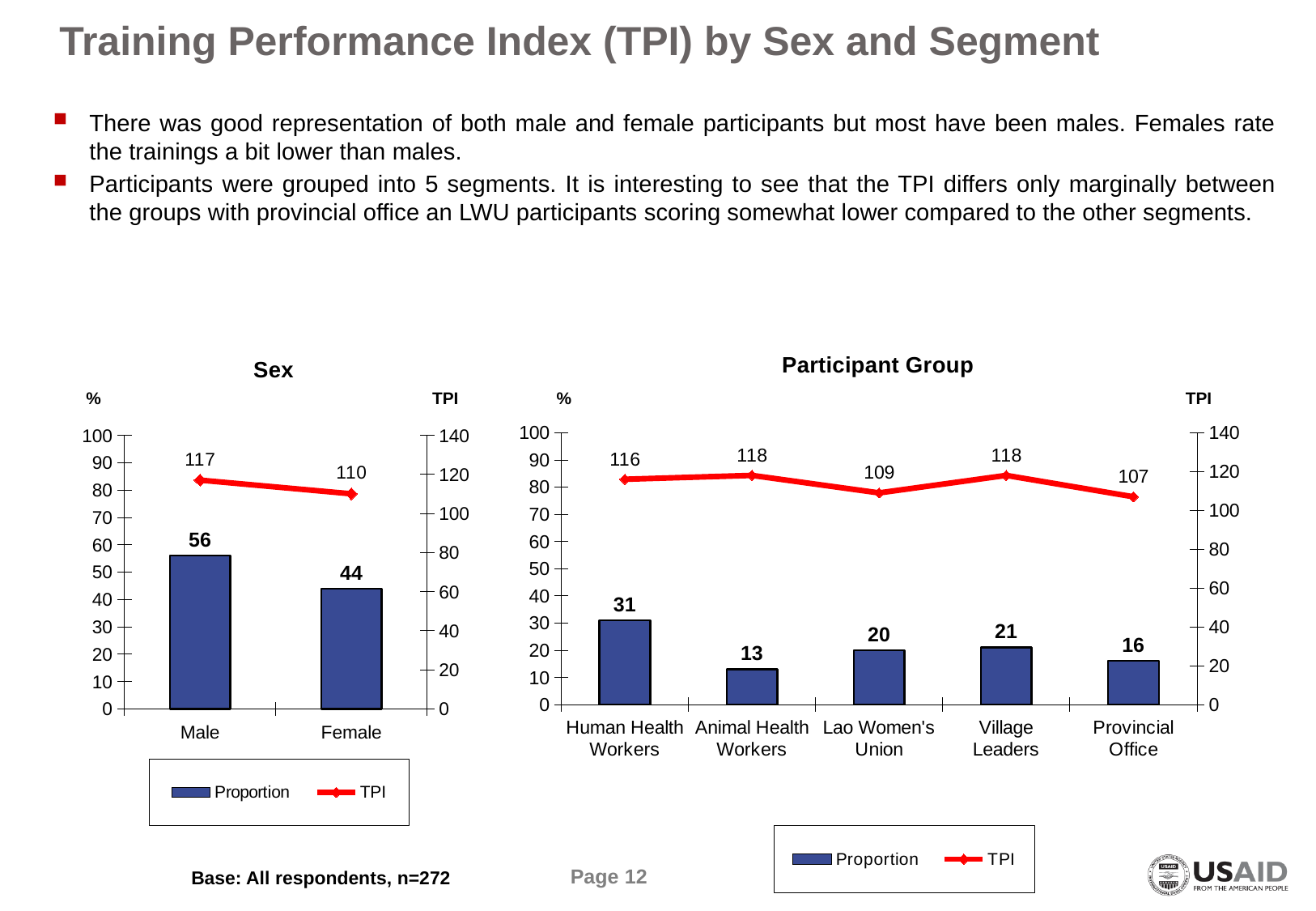
In the Participant Group chart, what is the TPI value for Lao Women's Union? 109 In the Sex chart, how many series does the legend list? 2 In the Sex chart, what is the Proportion value for Male? 56 What kind of chart is the Participant Group chart? Combined bar and line chart In the Sex chart, what is the difference between the TPI for Male and the TPI for Female? 7 In the Participant Group chart, what is the difference between the Proportion for Human Health Workers and the Proportion for Lao Women's Union? 11 In the Participant Group chart, which group has the lowest TPI? Provincial Office In the Participant Group chart, what is the Proportion value for Animal Health Workers? 13 In the Sex chart, what is the TPI value for Female? 110 In the Participant Group chart, which is larger, the Proportion for Village Leaders or the Proportion for Provincial Office? Village Leaders In the Participant Group chart, how many participant groups are shown on the x axis? 5 In the Participant Group chart, which group has the highest Proportion? Human Health Workers